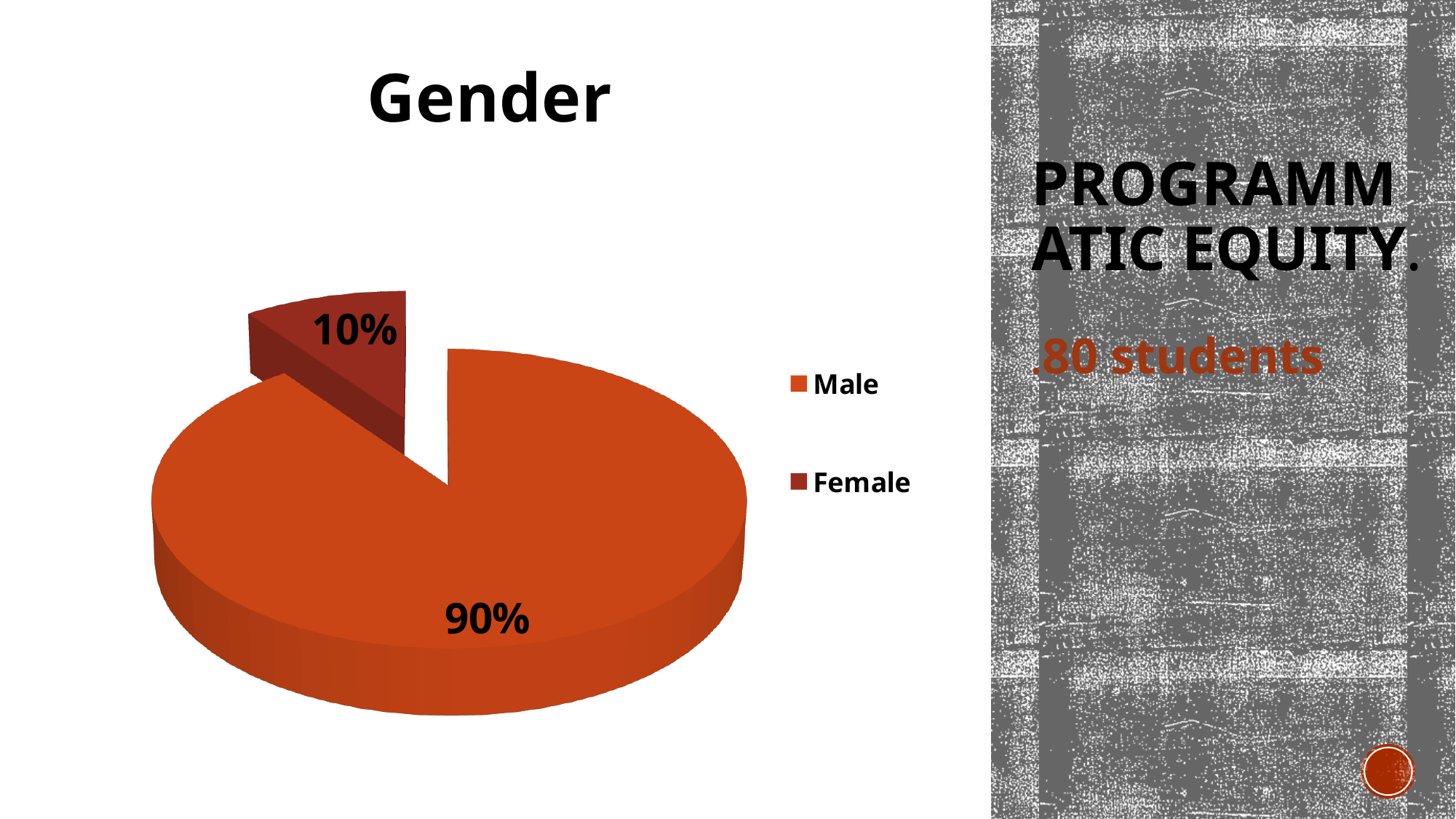
Which is larger in the Gender pie chart, Male or Female? Male What is the difference between the Male and Female shares in the Gender pie chart? 80% Which legend entry is shown in the darker red colour in the Gender pie chart? Female What is the title of the chart on the slide? Gender Which category has the largest share in the Gender pie chart? Male How many categories are shown in the Gender pie chart? 2 What is the value for Female in the Gender pie chart? 10% What is the value for Male in the Gender pie chart? 90% What share of the Gender pie chart does the Female slice represent? 10% What kind of chart is shown on the slide? Pie chart Which category has the smallest share in the Gender pie chart? Female